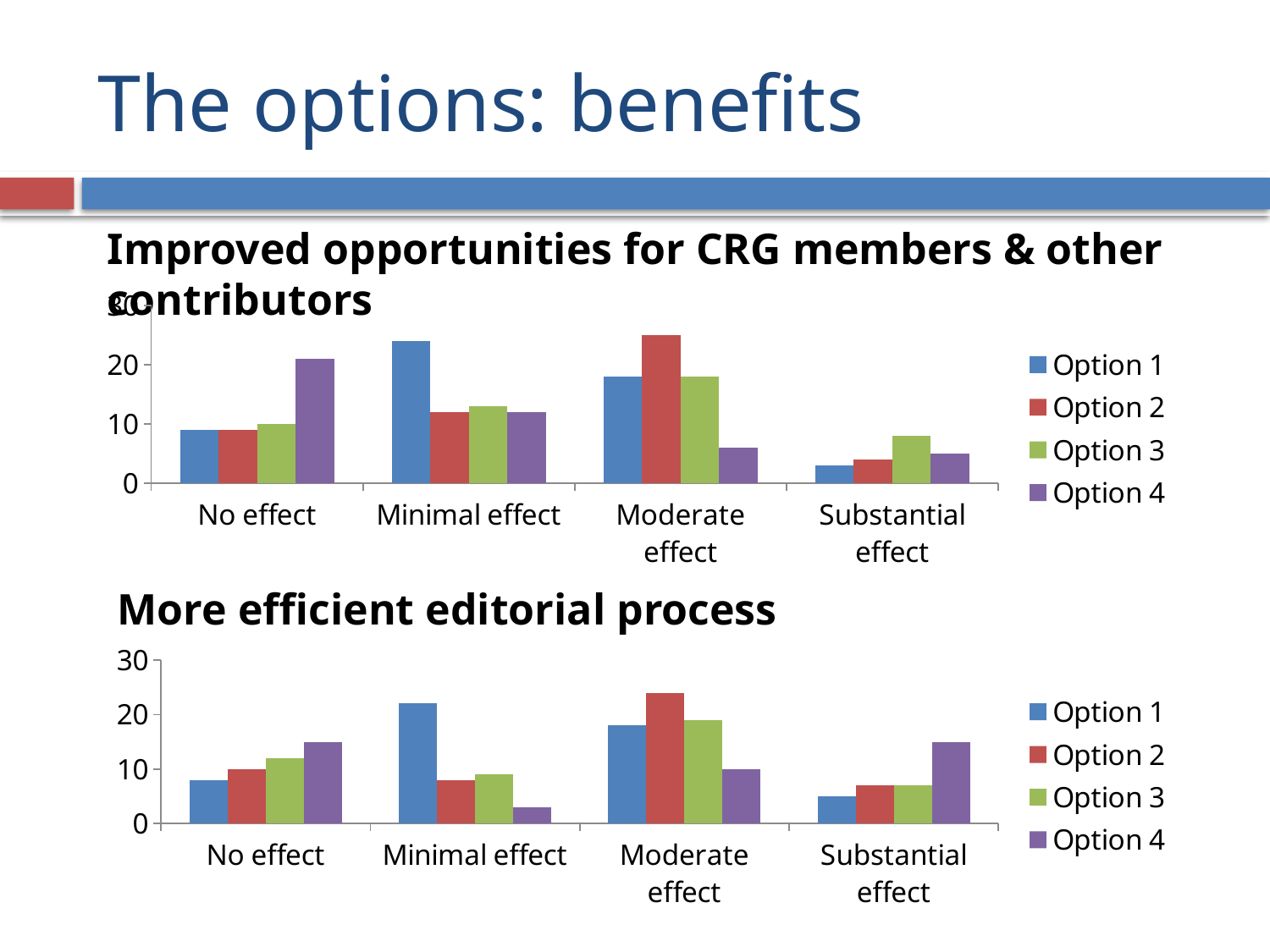
In the 'More efficient editorial process' chart, for 'Substantial effect', which is larger: Option 1 or Option 4? Option 4 In the 'More efficient editorial process' chart, which option has the highest value for 'Moderate effect'? Option 2 In the 'Improved opportunities for CRG members & other contributors' chart, for 'Moderate effect', which is larger: Option 2 or Option 4? Option 2 What kind of chart is the 'Improved opportunities for CRG members & other contributors' chart? bar chart In the 'Improved opportunities for CRG members & other contributors' chart, how many categories are shown on the x axis? 4 In the 'More efficient editorial process' chart, how many series does the legend list? 4 In the 'More efficient editorial process' chart, which option has the lowest value for 'Minimal effect'? Option 4 In the 'Improved opportunities for CRG members & other contributors' chart, which option has the highest value for 'Minimal effect'? Option 1 In the 'More efficient editorial process' chart, is the value for Option 4 at 'Minimal effect' greater or less than 10? less In the 'Improved opportunities for CRG members & other contributors' chart, is the value for Option 4 at 'Moderate effect' greater or less than 10? less In the 'Improved opportunities for CRG members & other contributors' chart, is the value for Option 1 at 'Minimal effect' greater or less than 20? greater What is the title of the lower chart on the slide? More efficient editorial process